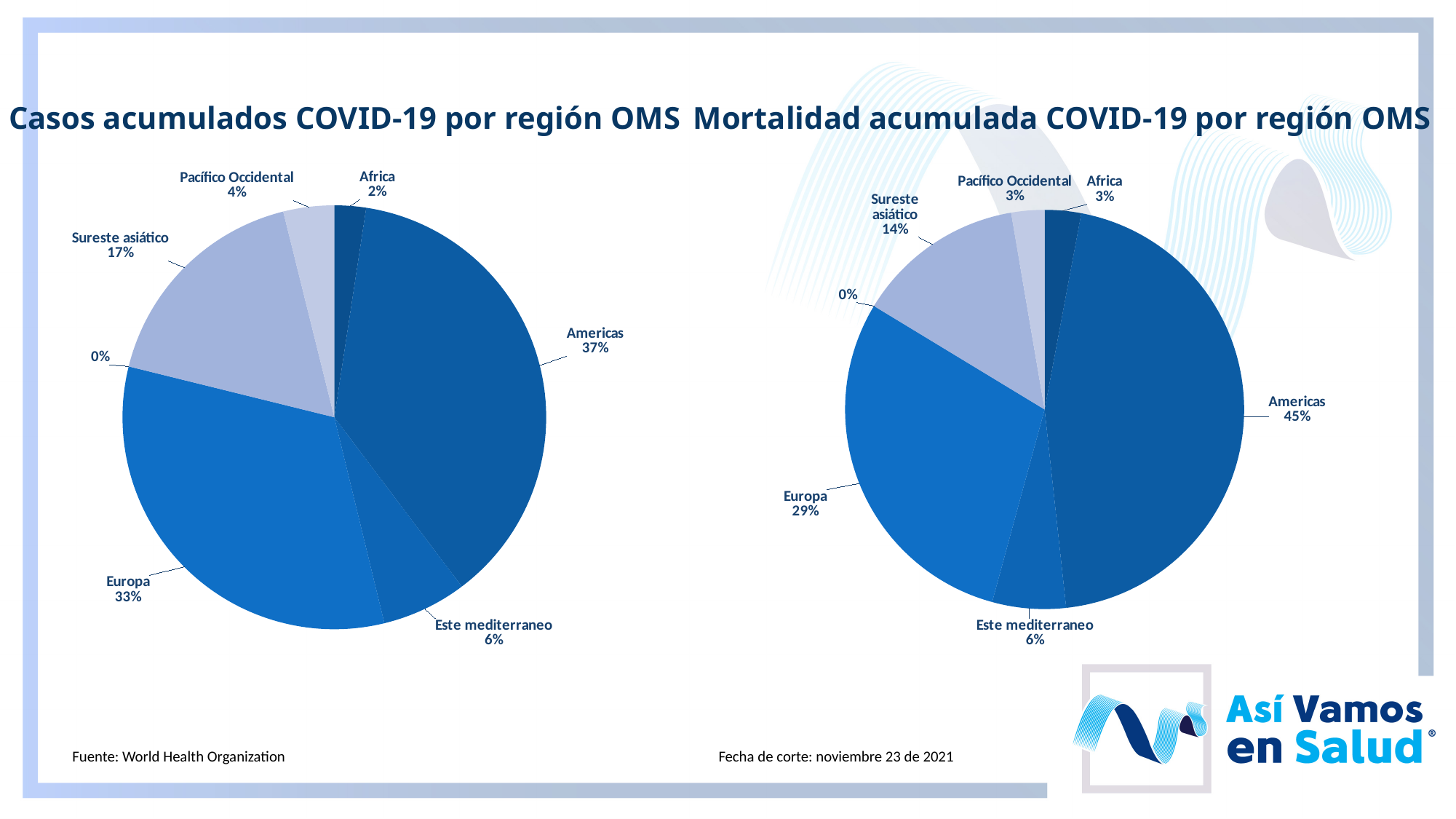
In the chart titled "Mortalidad acumulada COVID-19 por región OMS", which region has the largest slice? Americas What kind of chart is used on the left side of the slide, titled "Casos acumulados COVID-19 por región OMS"? Pie chart In the chart titled "Mortalidad acumulada COVID-19 por región OMS", what share does Sureste asiático have? 14% In the chart titled "Mortalidad acumulada COVID-19 por región OMS", what is the difference between the shares of Americas and Europa? 16% What is the title of the chart on the right side of the slide? Mortalidad acumulada COVID-19 por región OMS In the chart titled "Mortalidad acumulada COVID-19 por región OMS", which is larger, the share of Europa or the share of Sureste asiático? Europa In the chart titled "Casos acumulados COVID-19 por región OMS", what share of cases does Europa have? 33% In the chart titled "Casos acumulados COVID-19 por región OMS", what share of cases does Americas have? 37% In the chart titled "Casos acumulados COVID-19 por región OMS", which labeled region has the smallest non-zero slice? Africa In the chart titled "Casos acumulados COVID-19 por región OMS", which region has the largest slice? Americas In the chart titled "Casos acumulados COVID-19 por región OMS", what is the difference between the shares of Sureste asiático and Pacífico Occidental? 13% In the chart titled "Mortalidad acumulada COVID-19 por región OMS", what share does Americas have? 45%